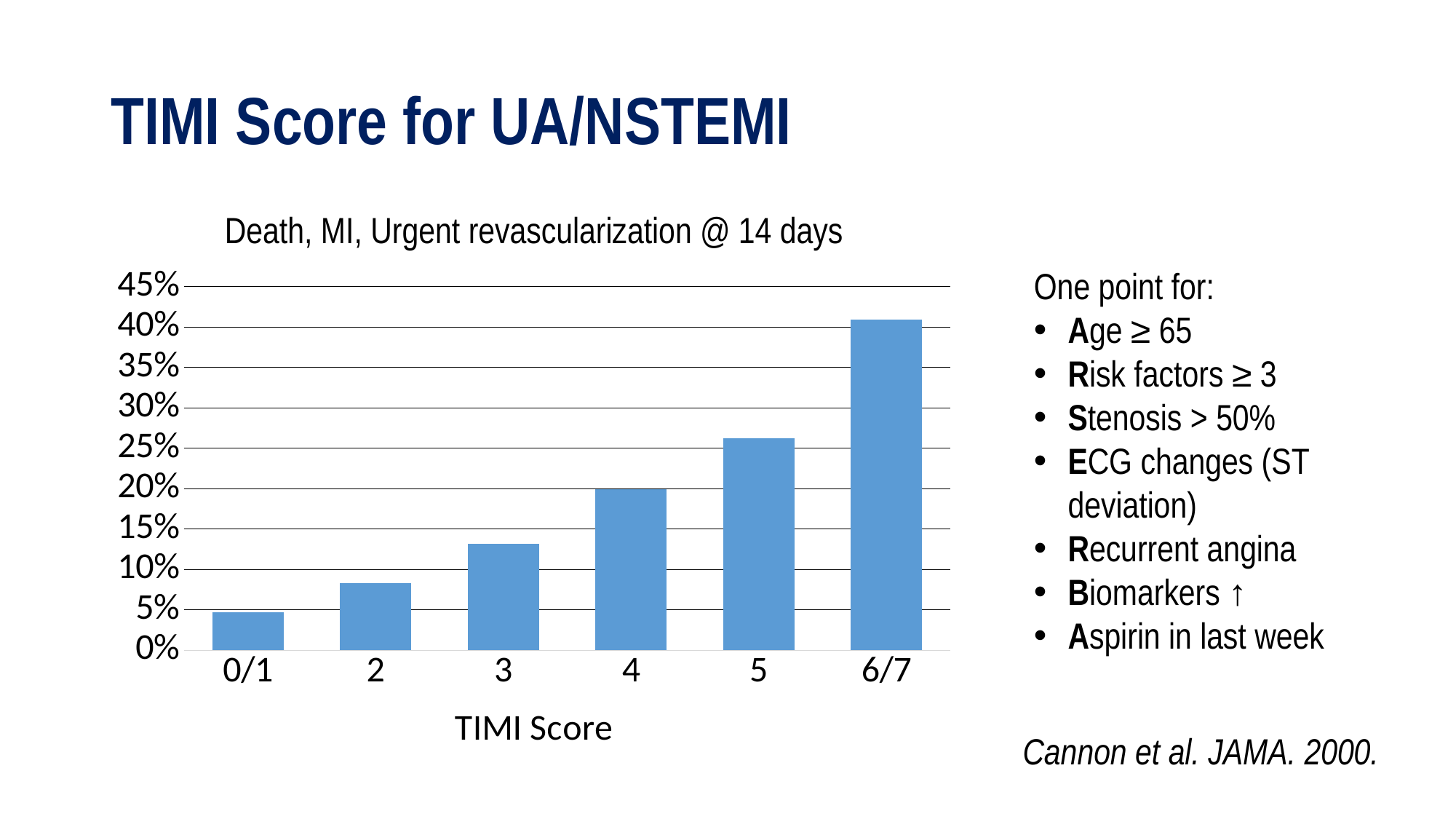
Which TIMI score category has the highest event rate? 6/7 Do the event rates rise or fall as the TIMI score increases along the x axis? rise What is the title of the chart? Death, MI, Urgent revascularization @ 14 days What is the label of the x axis of the chart? TIMI Score Is the value for TIMI score 3 greater or less than 15%? less Which has a higher event rate, TIMI score 2 or TIMI score 5? 5 Is the value for TIMI score 5 greater or less than 25%? greater Is the value for TIMI score 6/7 greater or less than 40%? greater What kind of chart is shown on the slide? bar chart How many TIMI score categories are plotted on the chart? 6 Which TIMI score category has the lowest event rate? 0/1